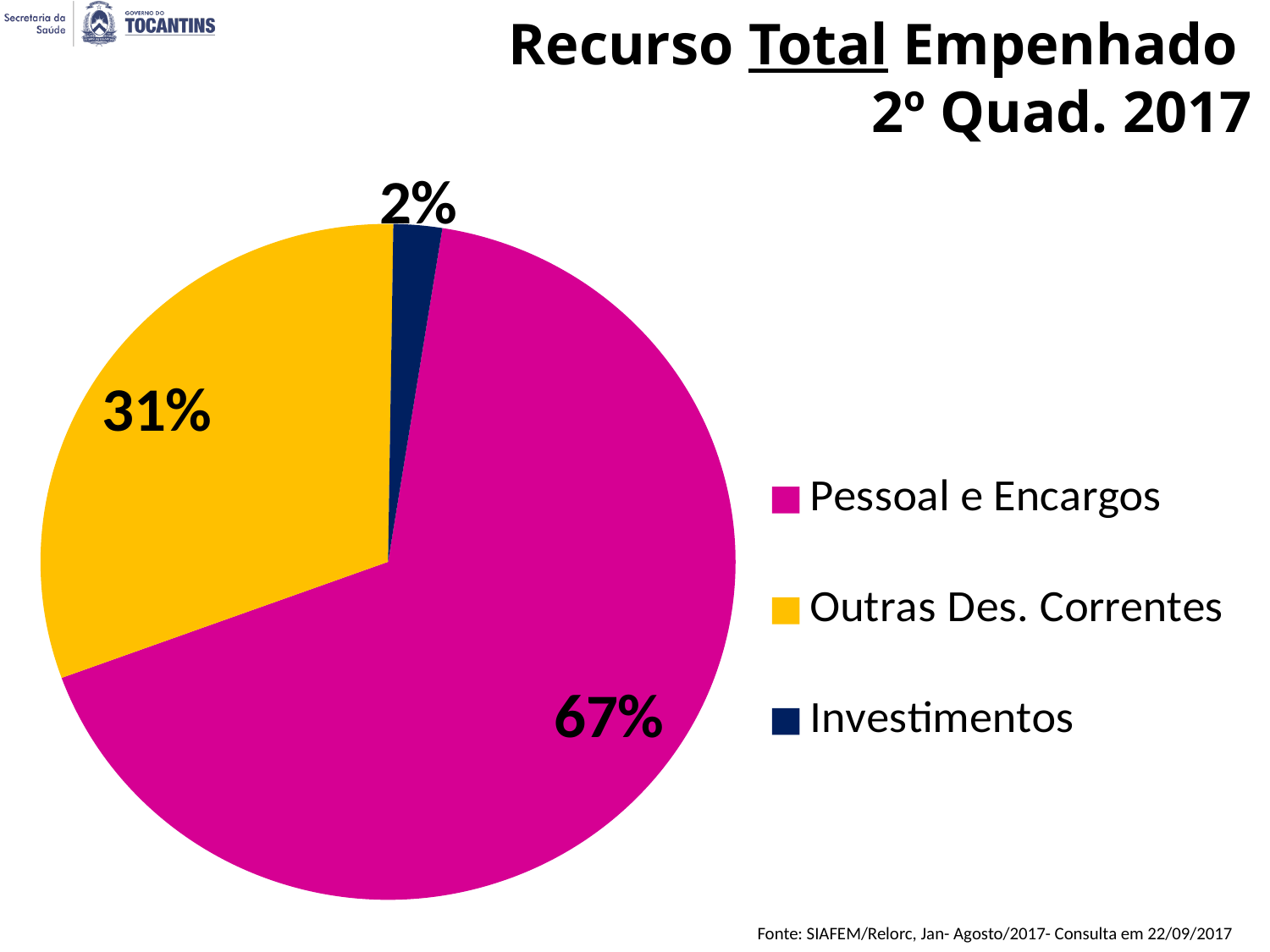
What colour is the slice for Investimentos? Dark blue How many categories are shown in the pie chart? 3 Which category has the largest slice of the pie? Pessoal e Encargos Which category has the smallest slice of the pie? Investimentos What share of the pie does Investimentos represent? 2% What is the title of the chart? Recurso Total Empenhado 2º Quad. 2017 What kind of chart is shown on the slide? Pie chart What is the difference in percentage points between Pessoal e Encargos and Outras Des. Correntes? 36 What is the difference in percentage points between Outras Des. Correntes and Investimentos? 29 What share of the pie does Outras Des. Correntes represent? 31% Which is larger, the share for Outras Des. Correntes or the share for Investimentos? Outras Des. Correntes What share of the pie does Pessoal e Encargos represent? 67%